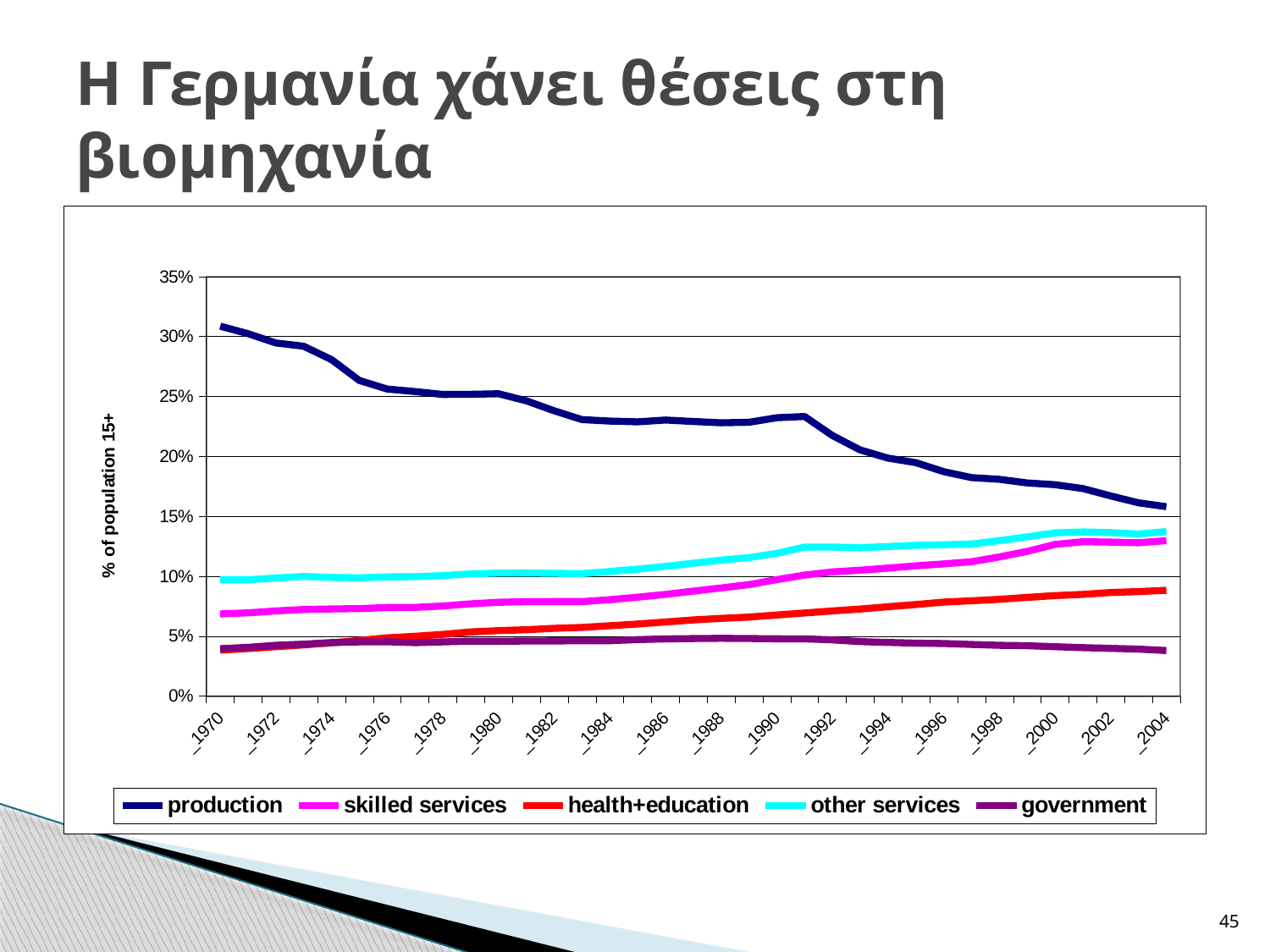
How many series does the legend list? 5 Which series has the highest value in 1970? production What is the label on the vertical axis? % of population 15+ Is the value for skilled services in 1970 greater or less than 10%? less Is the value for production in 1970 greater or less than 30%? greater Is the value for government in 2004 greater or less than 5%? less Which series has the lowest value in 2004? government What kind of chart is shown on the slide? line chart In 1990, which is larger: production or other services? production Does the production series rise or fall from 1970 to 2004? fall Does the health+education series rise or fall from 1970 to 2004? rise